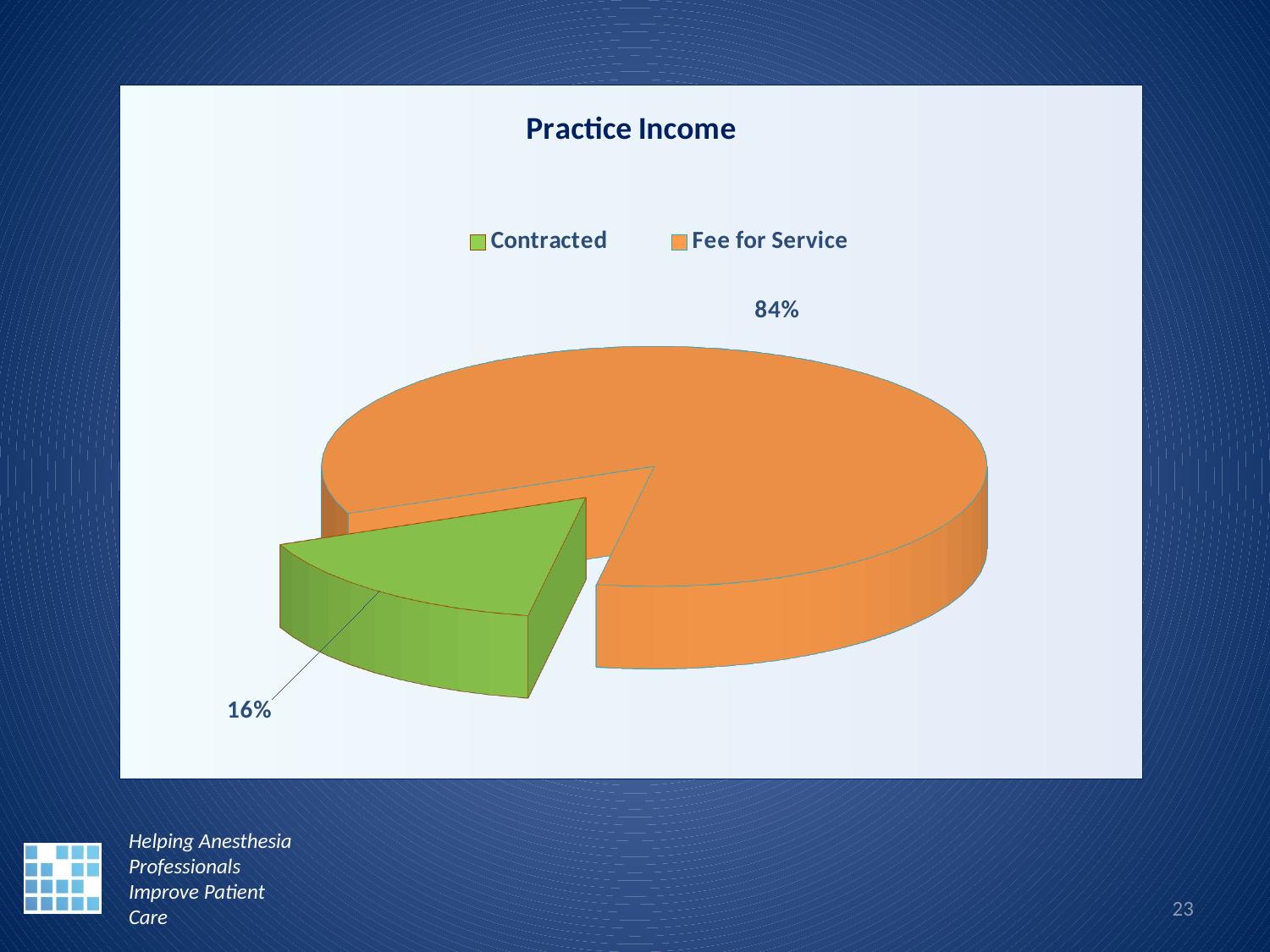
What kind of chart is shown on the slide? pie chart Which is larger, the Contracted share or the Fee for Service share? Fee for Service What colour is the Contracted slice? green How many categories does the pie chart show? 2 What share of practice income is Contracted? 16% Which category has the largest share of practice income? Fee for Service What is the title of the chart? Practice Income How many entries does the legend list? 2 What is the difference in percentage points between the Fee for Service and Contracted shares? 68 Which category has the smallest share of practice income? Contracted What share of practice income is Fee for Service? 84%